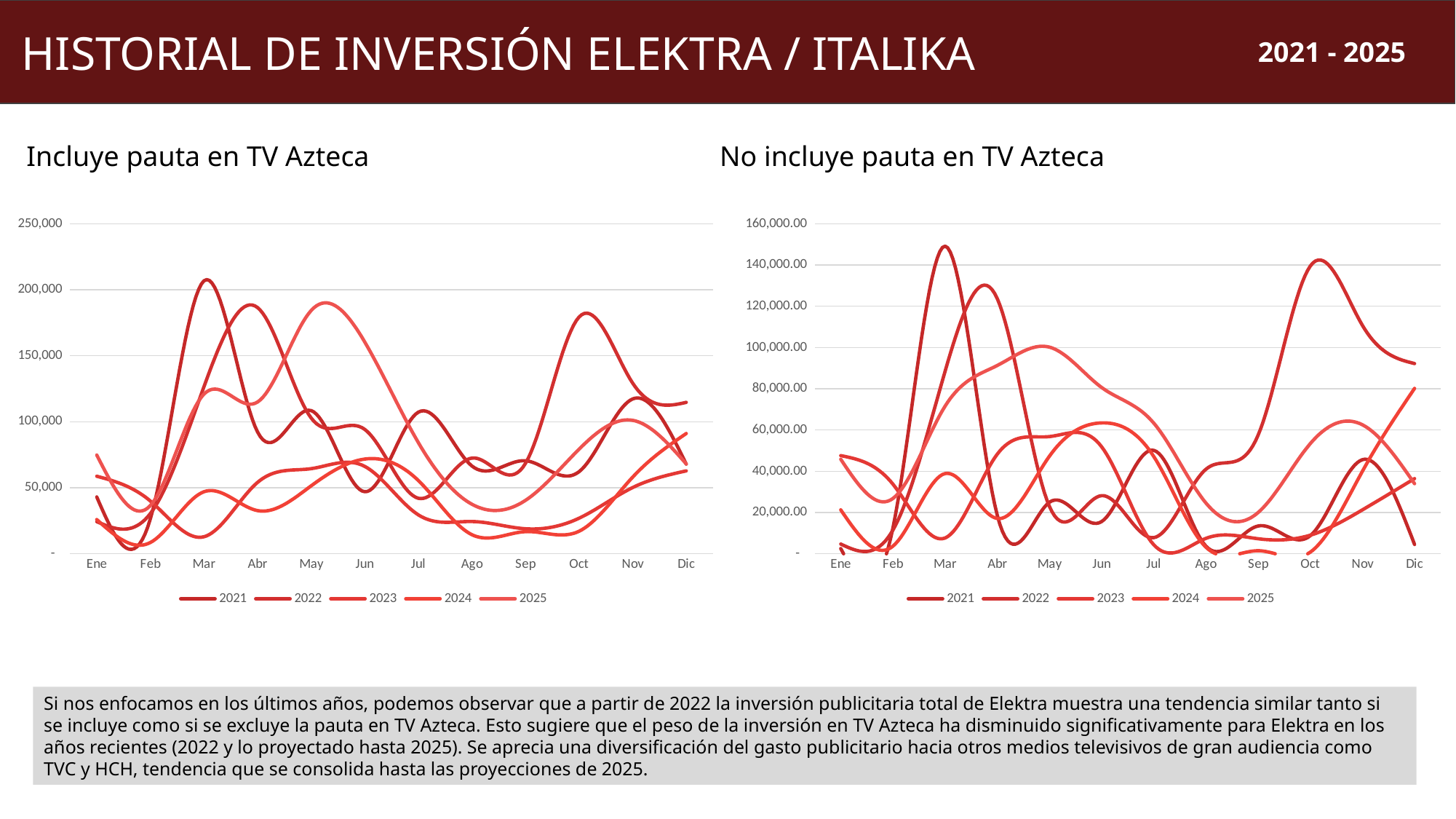
In the right chart 'No incluye pauta en TV Azteca', is the highest value plotted in Ago greater or less than 60,000.00? less In the left chart 'Incluye pauta en TV Azteca', is the highest value plotted in Ene greater or less than 100,000? less In the right chart 'No incluye pauta en TV Azteca', is the highest value plotted in Mar greater or less than 120,000.00? greater What is the first month label on the x axis of the left chart 'Incluye pauta en TV Azteca'? Ene What kind of chart is the left chart titled 'Incluye pauta en TV Azteca'? line chart What is the highest value shown on the y axis of the left chart 'Incluye pauta en TV Azteca'? 250,000 How many series does the legend of the left chart 'Incluye pauta en TV Azteca' list? 5 What kind of chart is the right chart titled 'No incluye pauta en TV Azteca'? line chart How many categories are shown on the x axis of the right chart 'No incluye pauta en TV Azteca'? 12 Which years are listed in the legend of the right chart 'No incluye pauta en TV Azteca'? 2021, 2022, 2023, 2024, 2025